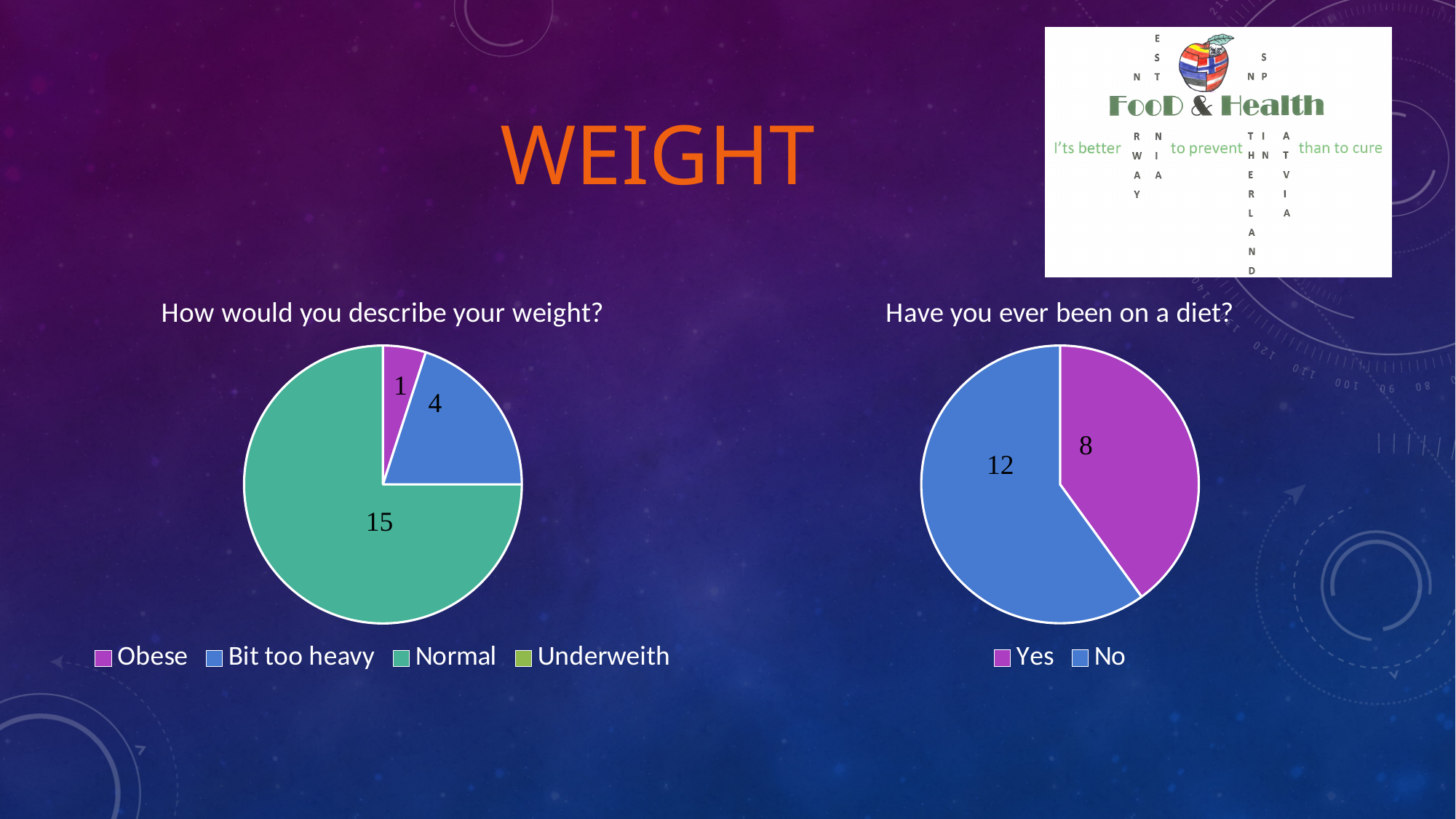
On the chart titled "Have you ever been on a diet?", what colour is the Yes slice? Purple On the chart titled "How would you describe your weight?", how many entries does the legend list? 4 On the chart titled "Have you ever been on a diet?", which is larger, Yes or No? No On the chart titled "Have you ever been on a diet?", what share of the pie does Yes represent? 40% On the chart titled "Have you ever been on a diet?", what is the value for Yes? 8 On the chart titled "Have you ever been on a diet?", what is the value for No? 12 On the chart titled "How would you describe your weight?", what is the value for Normal? 15 On the chart titled "How would you describe your weight?", what is the difference between the Normal and Bit too heavy values? 11 On the chart titled "How would you describe your weight?", what is the value for Bit too heavy? 4 On the chart titled "How would you describe your weight?", which category has the largest slice? Normal On the chart titled "How would you describe your weight?", what is the value for Obese? 1 What kind of chart is the chart titled "How would you describe your weight?"? Pie chart